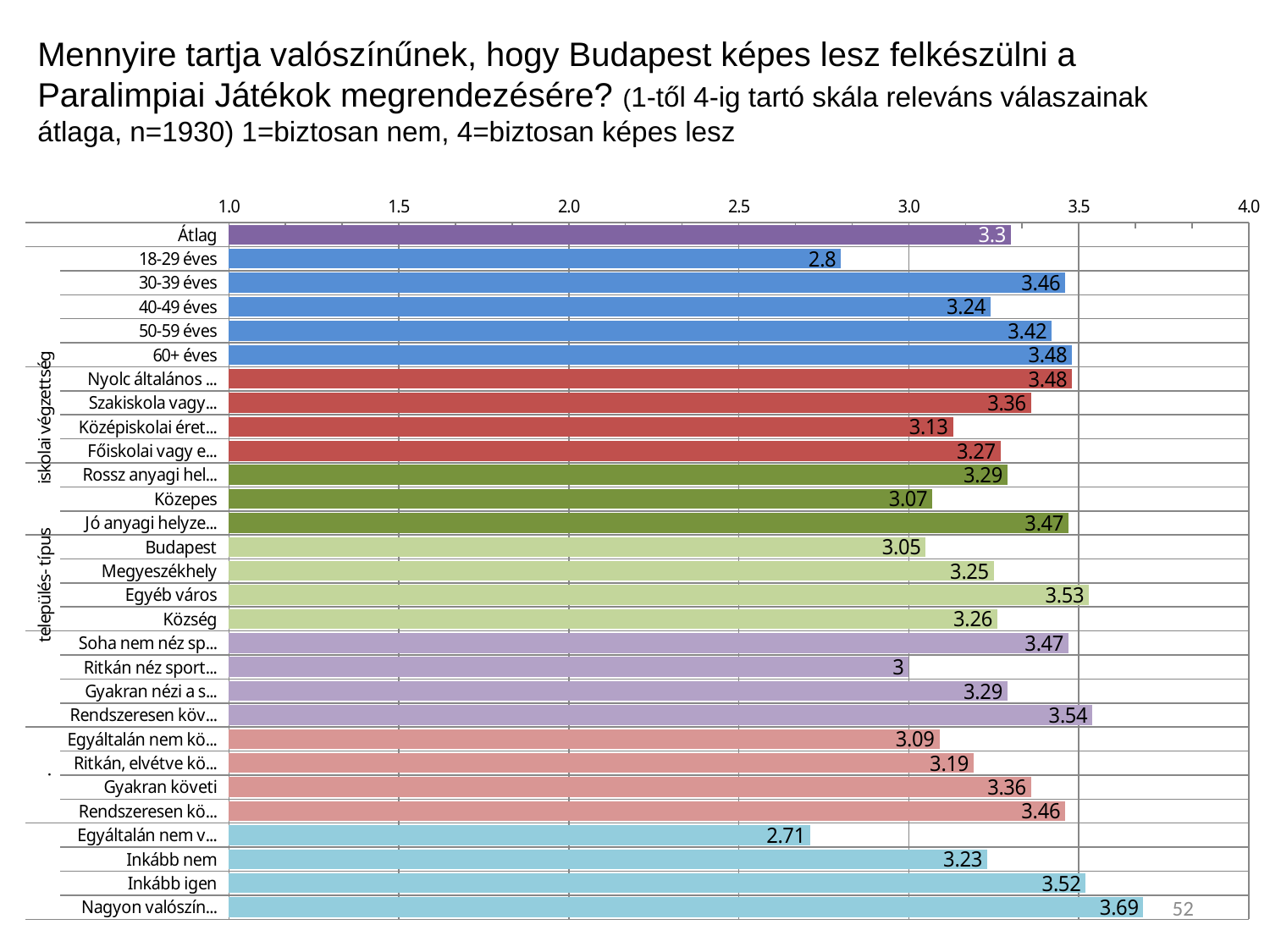
What is the difference between the values for Inkább igen and Inkább nem? 0.29 What is the value for Átlag? 3.3 What is the value for 18-29 éves? 2.8 Among the age groups (18-29 éves to 60+ éves), which has the lowest value? 18-29 éves What is the value for Egyéb város? 3.53 What is the value for Inkább nem? 3.23 How many bars are plotted in the chart? 29 What is the difference between the values for 30-39 éves and 18-29 éves? 0.66 What kind of chart is shown on the slide? bar chart Which has a larger value, Budapest or Egyéb város? Egyéb város Is the value for 18-29 éves greater or less than 3.0? less Among the age groups (18-29 éves to 60+ éves), which has the highest value? 60+ éves